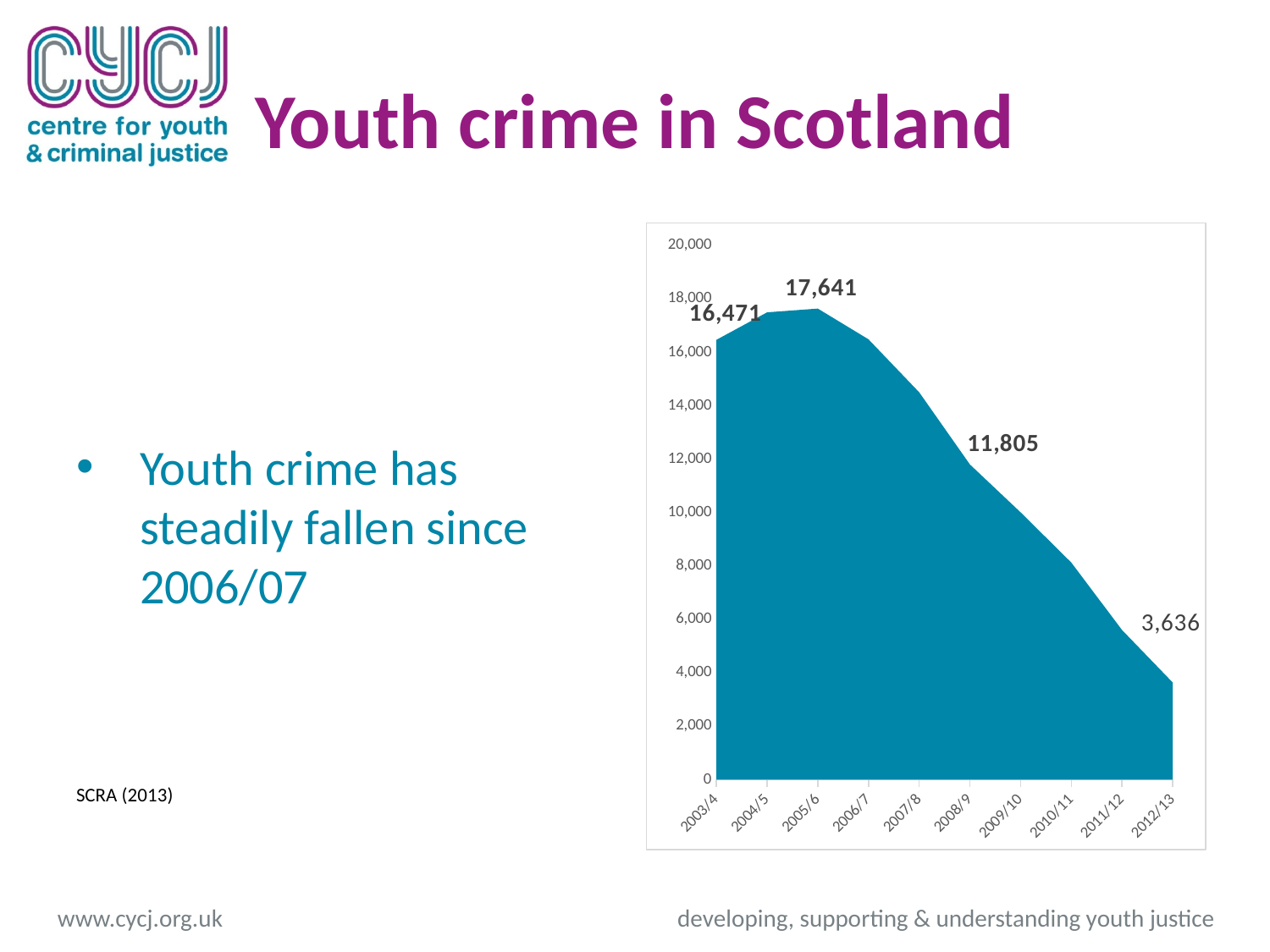
Is the value for 2006/7 greater or less than 16,000? greater What kind of chart is shown on the slide? area chart What is the difference between the values for 2005/6 and 2012/13? 14,005 What is the difference between the values for 2003/4 and 2008/9? 4,666 How many years are plotted on the x axis? 10 Which is larger, the value for 2003/4 or the value for 2008/9? 2003/4 What is the value for 2005/6? 17,641 What is the value for 2012/13? 3,636 Which year has the lowest value? 2012/13 What is the value for 2003/4? 16,471 What is the value for 2008/9? 11,805 Which year has the highest value? 2005/6